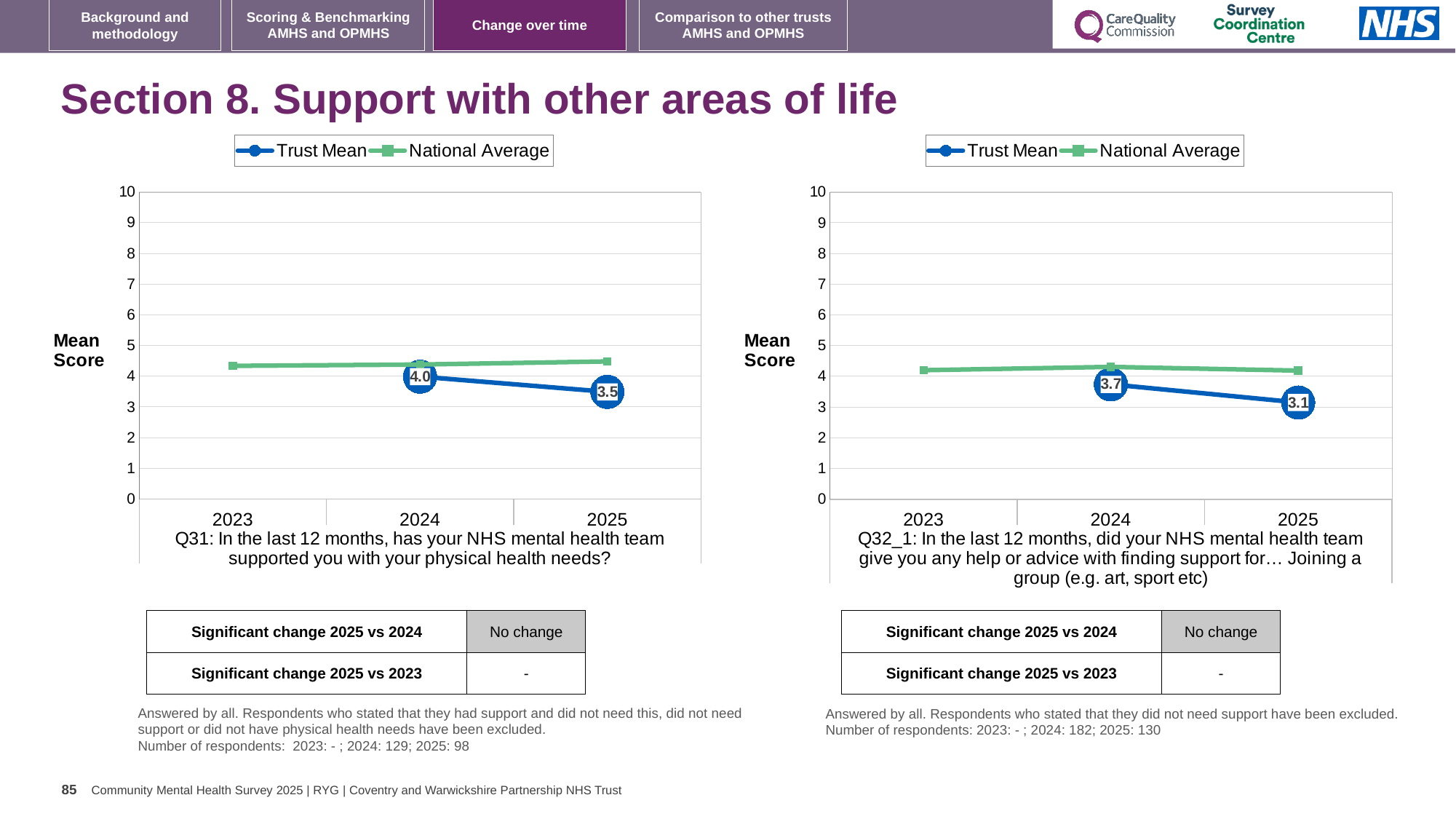
How many series does the legend of the left chart (Q31) list? 2 In the left chart (Q31), by how much did the Trust Mean fall from 2024 to 2025? 0.5 In the right chart (Q32_1), what is the Trust Mean value for 2025? 3.1 What kind of chart is the right chart (Q32_1)? line chart In the right chart (Q32_1), does the Trust Mean rise or fall from 2024 to 2025? fall How many years are shown on the x axis of the left chart (Q31)? 3 In the left chart (Q31), what is the Trust Mean value for 2025? 3.5 In the right chart (Q32_1), which is larger in 2025, the Trust Mean or the National Average? National Average In the right chart (Q32_1), what is the Trust Mean value for 2024? 3.7 In the right chart (Q32_1), what is the difference between the Trust Mean in 2024 and in 2025? 0.6 In the left chart (Q31), is the National Average for 2025 greater or less than 4? greater In the left chart (Q31), what is the Trust Mean value for 2024? 4.0